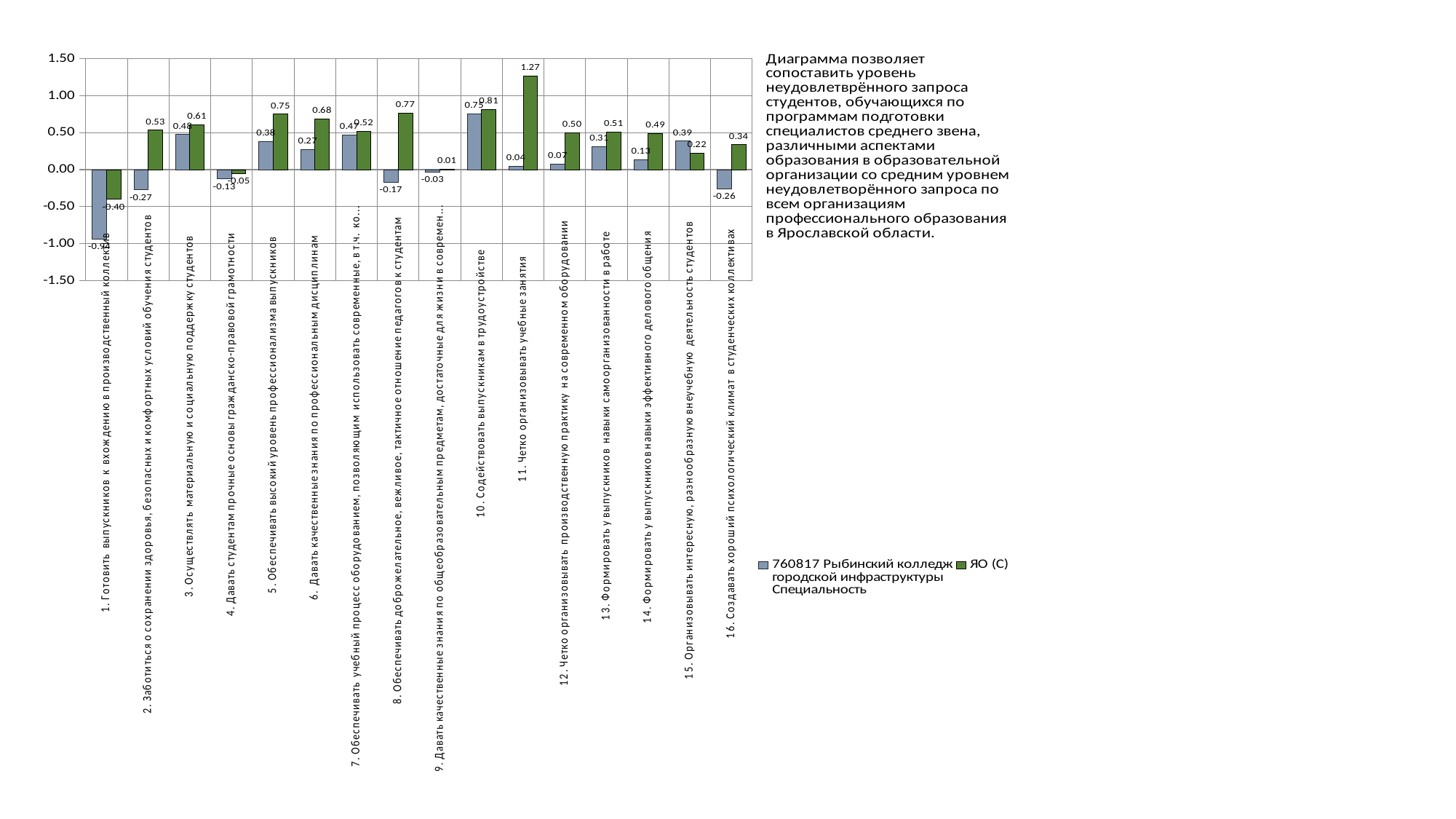
Which category has the highest value for the ЯО (С) series? 11. Четко организовывать учебные занятия How many series does the legend list? 2 What colour are the bars for the ЯО (С) series? green Is the value of the Рыбинский колледж series for category 1 greater or less than -0.50? less What kind of chart is shown on the slide? bar chart For category 15 (Организовывать интересную, разнообразную внеучебную деятельность студентов), which series has the larger value? 760817 Рыбинский колледж городской инфраструктуры Специальность What is the value of the ЯО (С) series for category 11 (Четко организовывать учебные занятия)? 1.27 What is the value of the ЯО (С) series for category 6 (Давать качественные знания по профессиональным дисциплинам)? 0.68 For category 8 (Обеспечивать доброжелательное, вежливое, тактичное отношение педагогов к студентам), what is the difference between the ЯО (С) value and the Рыбинский колледж value? 0.94 How many categories are plotted along the x axis? 16 What is the value of the 760817 Рыбинский колледж городской инфраструктуры series for category 10 (Содействовать выпускникам в трудоустройстве)? 0.75 Which category has the lowest value for the ЯО (С) series? 1. Готовить выпускников к вхождению в производственный коллектив